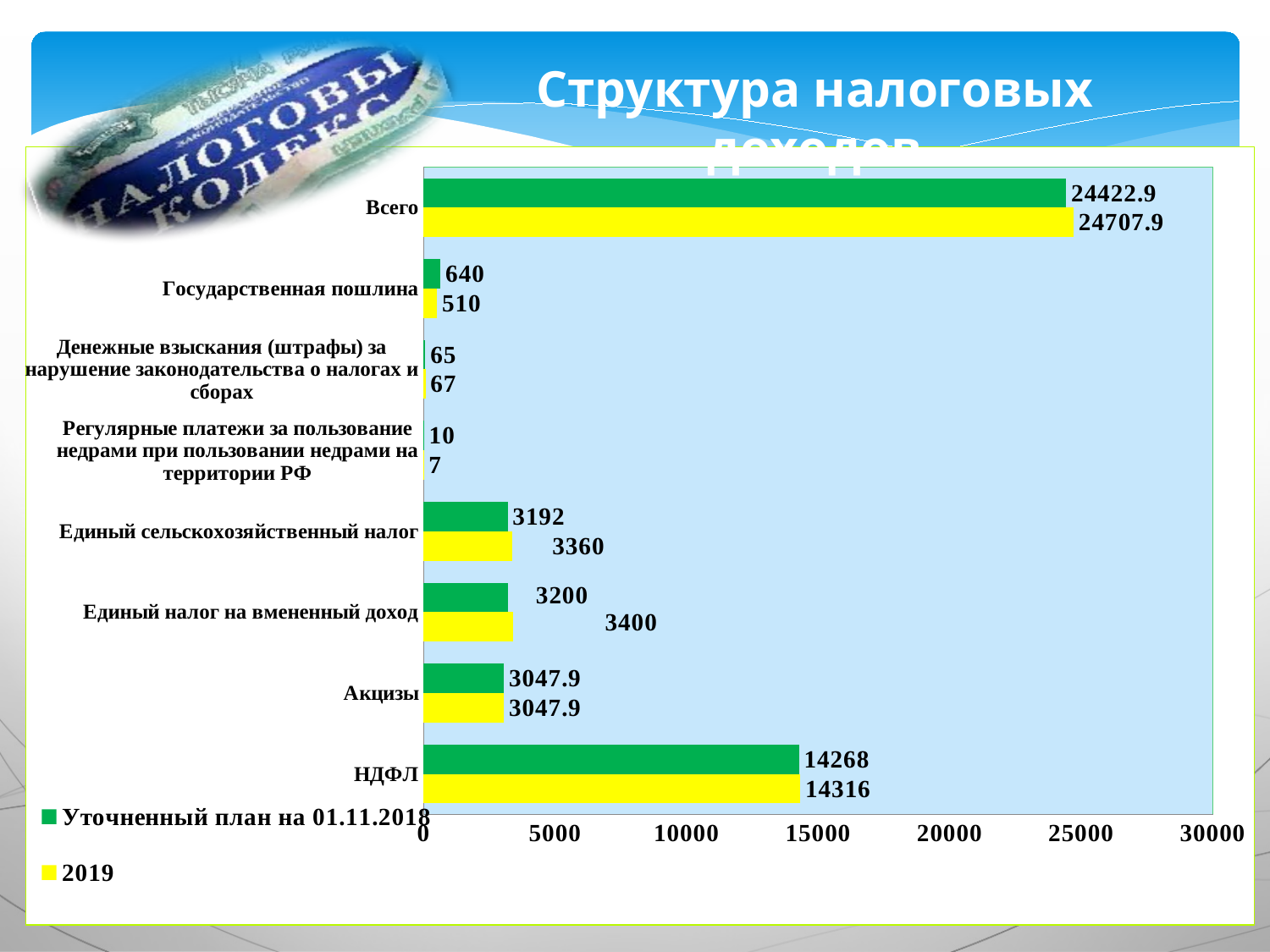
How many series does the legend list? 2 What type of chart is shown on the slide? bar chart What is the value for НДФЛ in the 2019 series? 14316 What is the difference between the 2019 value and the Уточненный план на 01.11.2018 value for Единый сельскохозяйственный налог? 168 Which colour represents the 2019 series in the chart? yellow Excluding Всего, which category has the highest value in the 2019 series? НДФЛ What is the value for Всего in the 2019 series? 24707.9 Which category has the lowest value in the Уточненный план на 01.11.2018 series? Регулярные платежи за пользование недрами при пользовании недрами на территории РФ What is the value for Государственная пошлина in the Уточненный план на 01.11.2018 series? 640 How many categories are plotted on the chart? 8 For Государственная пошлина, which series has the larger value: Уточненный план на 01.11.2018 or 2019? Уточненный план на 01.11.2018 What is the value for Единый налог на вмененный доход in the 2019 series? 3400